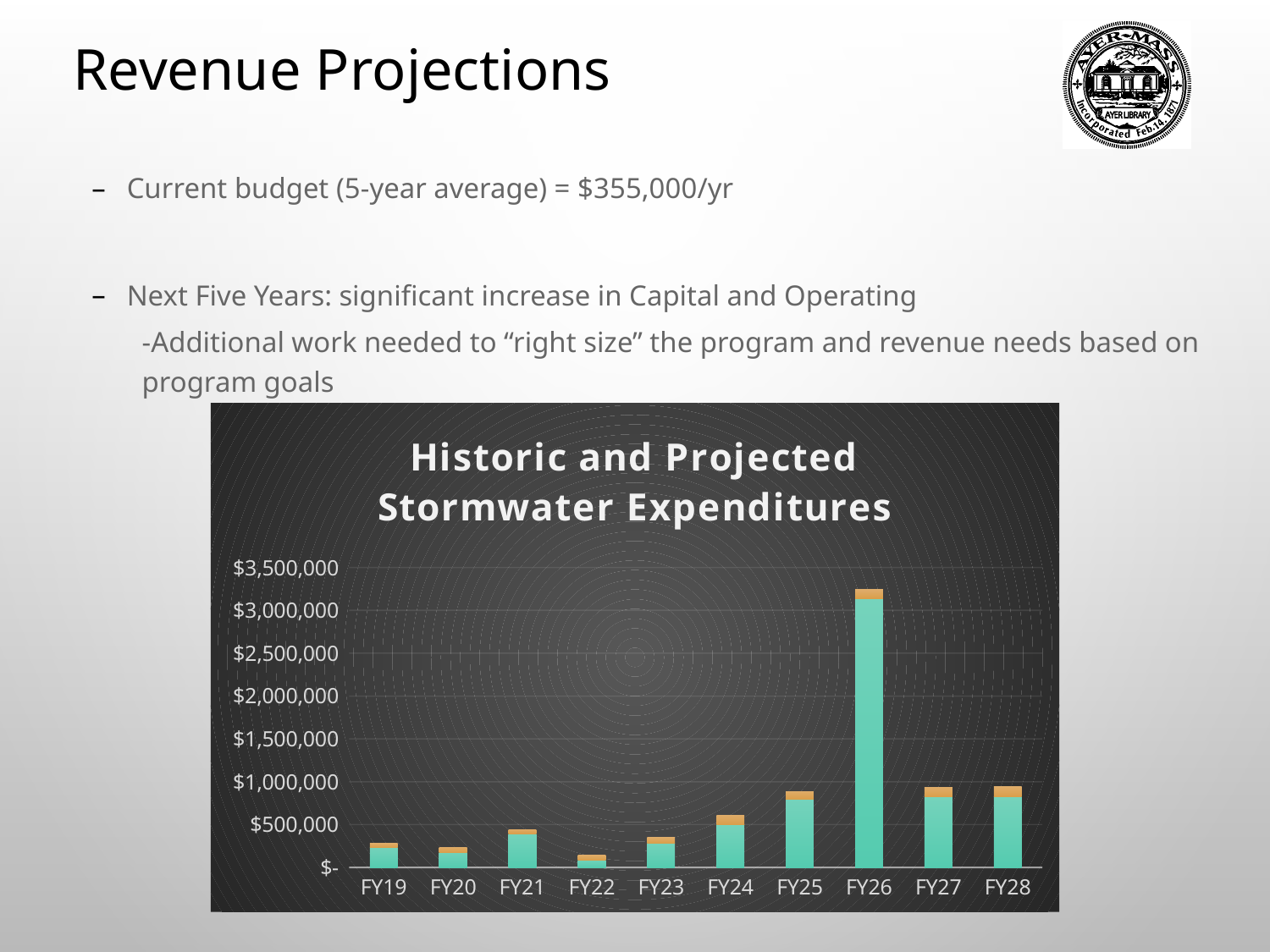
Is the total value for FY24 greater or less than $500,000? greater What is the title of the chart? Historic and Projected Stormwater Expenditures How many fiscal years are shown on the x axis of the chart? 10 What kind of chart is shown on the slide? bar chart Is the total value for FY22 greater or less than $500,000? less Which has the larger total expenditure, FY25 or FY24? FY25 Is the total value for FY21 greater or less than $500,000? less Which fiscal year has the highest total expenditure in the chart? FY26 Which has the larger total expenditure, FY21 or FY23? FY21 Which fiscal year has the lowest total expenditure in the chart? FY22